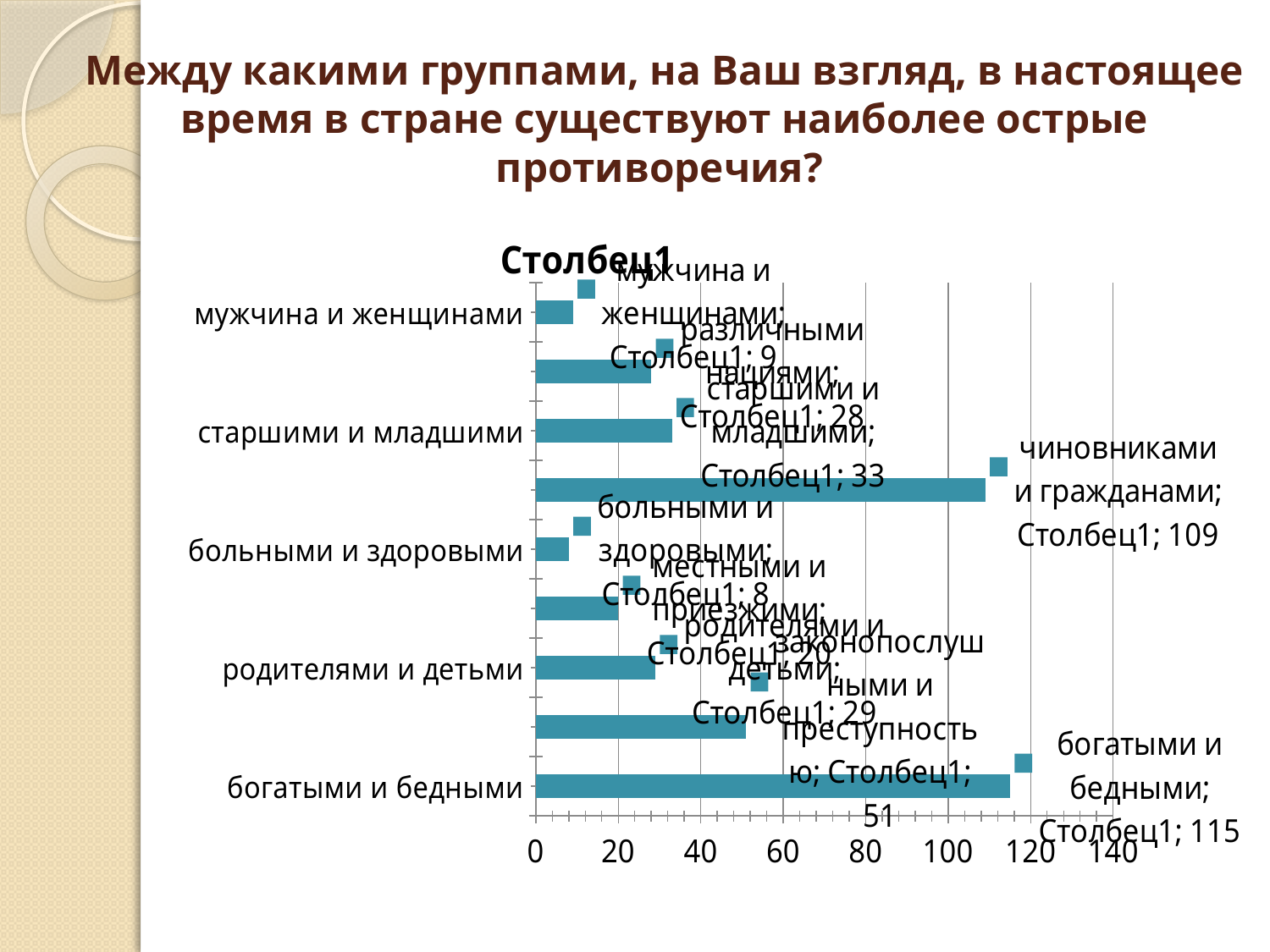
What is the value for "мужчина и женщинами"? 9 Which is larger: the value for "старшими и младшими" or for "родителями и детьми"? старшими и младшими How many bars are plotted in the chart? 9 What is the value for "чиновниками и гражданами"? 109 What is the difference between the values for "богатыми и бедными" and "чиновниками и гражданами"? 6 Which category has the highest value? богатыми и бедными What is the value for "родителями и детьми"? 29 What is the value for "богатыми и бедными"? 115 What is the value for "старшими и младшими"? 33 What type of chart is shown on the slide? bar chart Is the value for "чиновниками и гражданами" greater or less than 100? greater Which category has the lowest value? больными и здоровыми